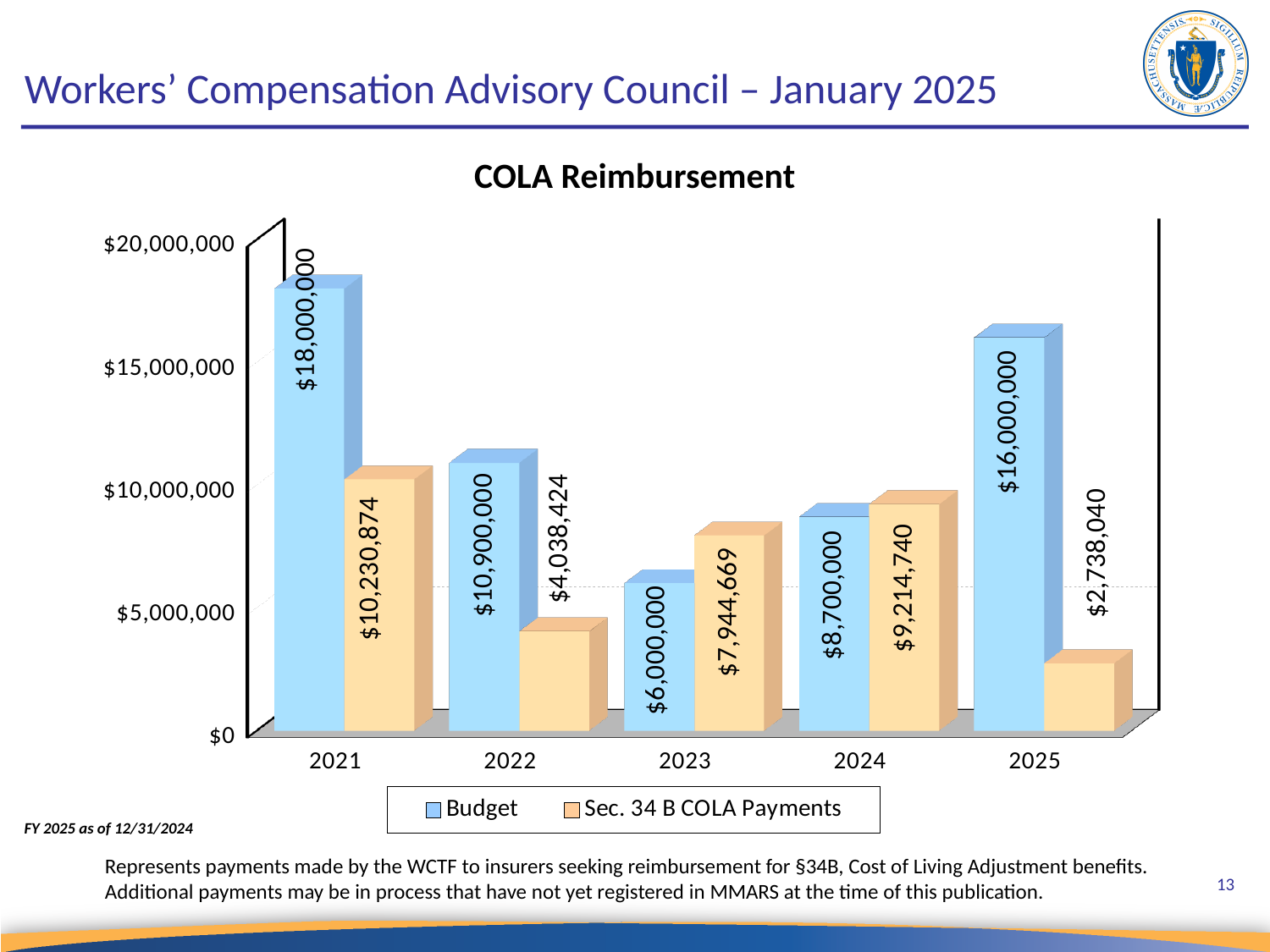
What is the Budget value for 2024? $8,700,000 How many series does the legend list? 2 Which year has the highest Budget value? 2021 What is the difference between the Sec. 34 B COLA Payments and the Budget in 2024? $514,740 What is the Sec. 34 B COLA Payments value for 2023? $7,944,669 How many years are shown on the x axis? 5 What kind of chart is shown on the slide? Bar chart In 2023, which is larger: the Budget or the Sec. 34 B COLA Payments? Sec. 34 B COLA Payments What is the Sec. 34 B COLA Payments value for 2025? $2,738,040 What is the difference between the Budget and the Sec. 34 B COLA Payments in 2021? $7,769,126 Which year has the lowest Sec. 34 B COLA Payments value? 2025 What is the Budget value for 2021? $18,000,000